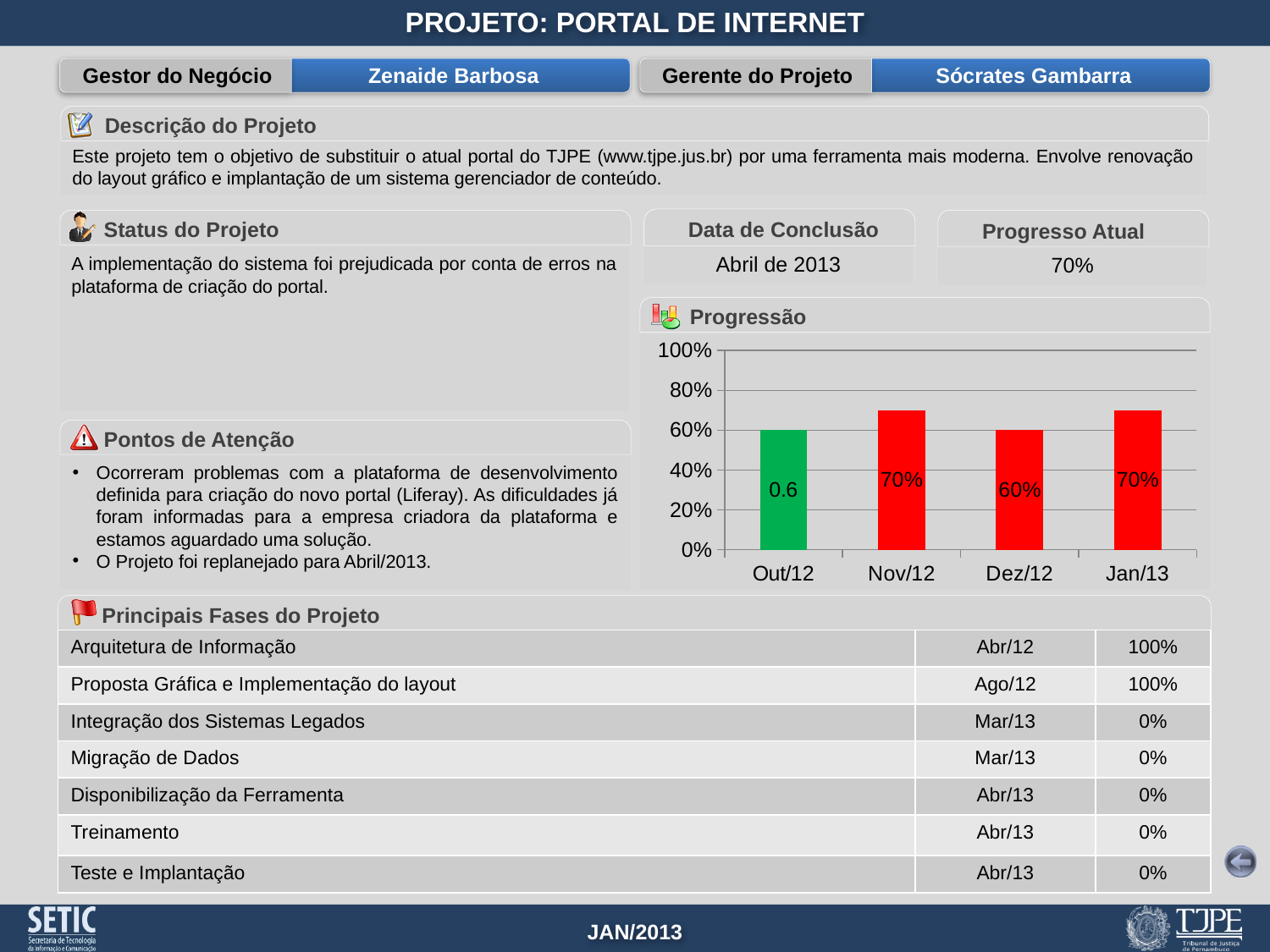
In the Progressão chart, does the value rise or fall from Nov/12 to Dez/12? fall In the Progressão chart, what is the difference between the values for Jan/13 and Dez/12? 10% What is the value for Jan/13 in the Progressão chart? 70% What is the value for Dez/12 in the Progressão chart? 60% What is the data label shown on the Out/12 bar in the Progressão chart? 0.6 In the Progressão chart, is the value for Nov/12 greater or less than 80%? less How many months are shown on the x axis of the Progressão chart? 4 What colour is the Out/12 bar in the Progressão chart? green In the Progressão chart, is the value for Out/12 greater or less than 40%? greater In the Progressão chart, which is larger, the value for Nov/12 or the value for Dez/12? Nov/12 What kind of chart is the Progressão chart? bar chart What is the value for Nov/12 in the Progressão chart? 70%